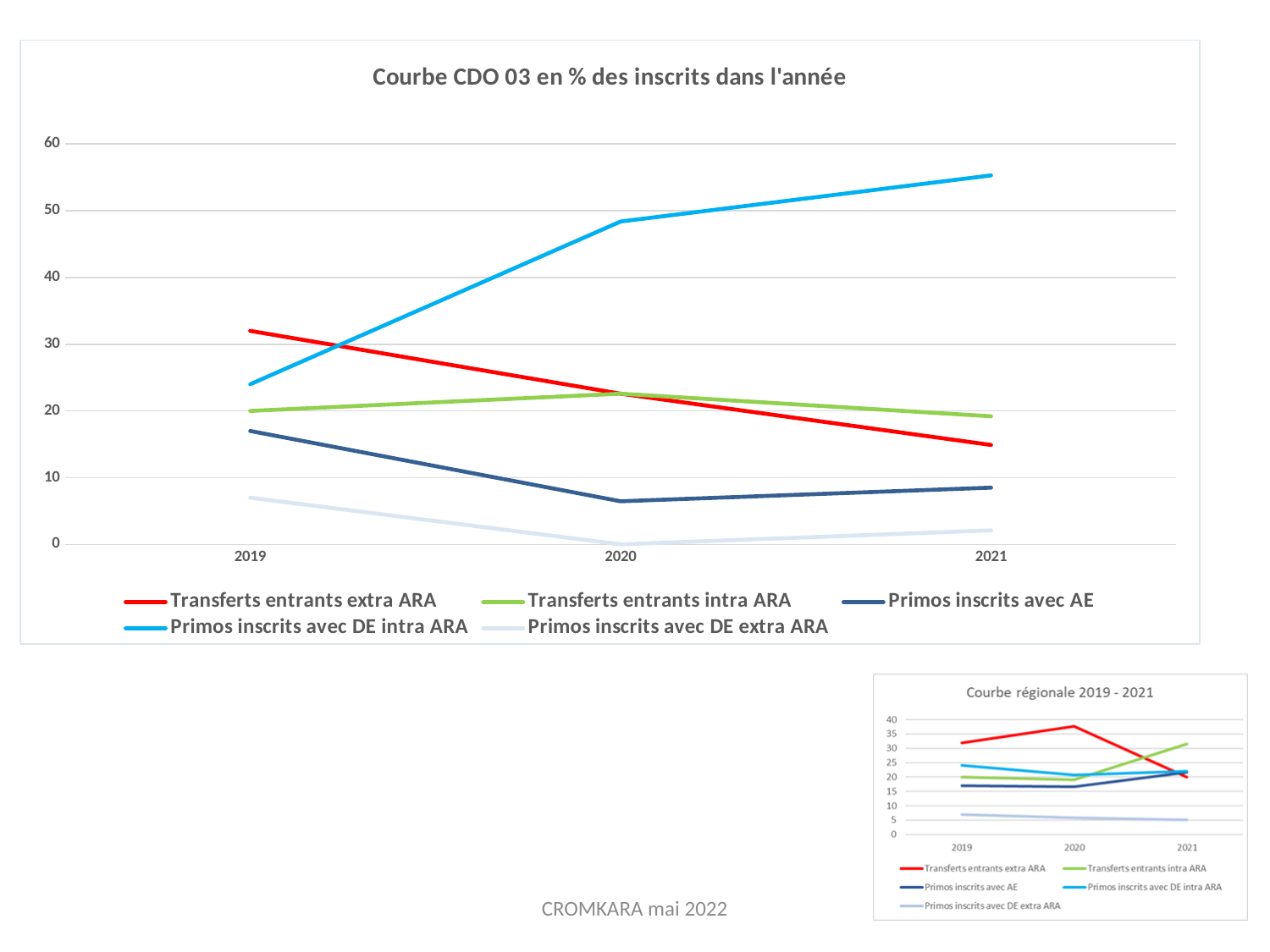
In the 'Courbe CDO 03 en % des inscrits dans l'année' chart, is the value for 'Primos inscrits avec AE' in 2020 greater or less than 10? less In the 'Courbe CDO 03 en % des inscrits dans l'année' chart, how many series does the legend list? 5 In the 'Courbe régionale 2019 - 2021' chart, which series has the highest value in 2021? Transferts entrants intra ARA In the 'Courbe CDO 03 en % des inscrits dans l'année' chart, does the 'Primos inscrits avec DE intra ARA' line rise or fall from 2019 to 2021? Rise In the 'Courbe CDO 03 en % des inscrits dans l'année' chart, which is larger in 2019: 'Transferts entrants extra ARA' or 'Primos inscrits avec DE intra ARA'? Transferts entrants extra ARA In the 'Courbe CDO 03 en % des inscrits dans l'année' chart, is the value for 'Primos inscrits avec DE intra ARA' in 2021 greater or less than 50? greater In the 'Courbe CDO 03 en % des inscrits dans l'année' chart, how many years are shown on the x axis? 3 In the 'Courbe CDO 03 en % des inscrits dans l'année' chart, which series has the highest value in 2021? Primos inscrits avec DE intra ARA In the 'Courbe CDO 03 en % des inscrits dans l'année' chart, which series has the lowest value in 2020? Primos inscrits avec DE extra ARA What kind of chart is the 'Courbe CDO 03 en % des inscrits dans l'année' chart? Line chart In the 'Courbe CDO 03 en % des inscrits dans l'année' chart, does the 'Transferts entrants extra ARA' line rise or fall from 2019 to 2021? Fall In the 'Courbe régionale 2019 - 2021' chart, is the value for 'Transferts entrants extra ARA' in 2020 greater or less than 35? greater